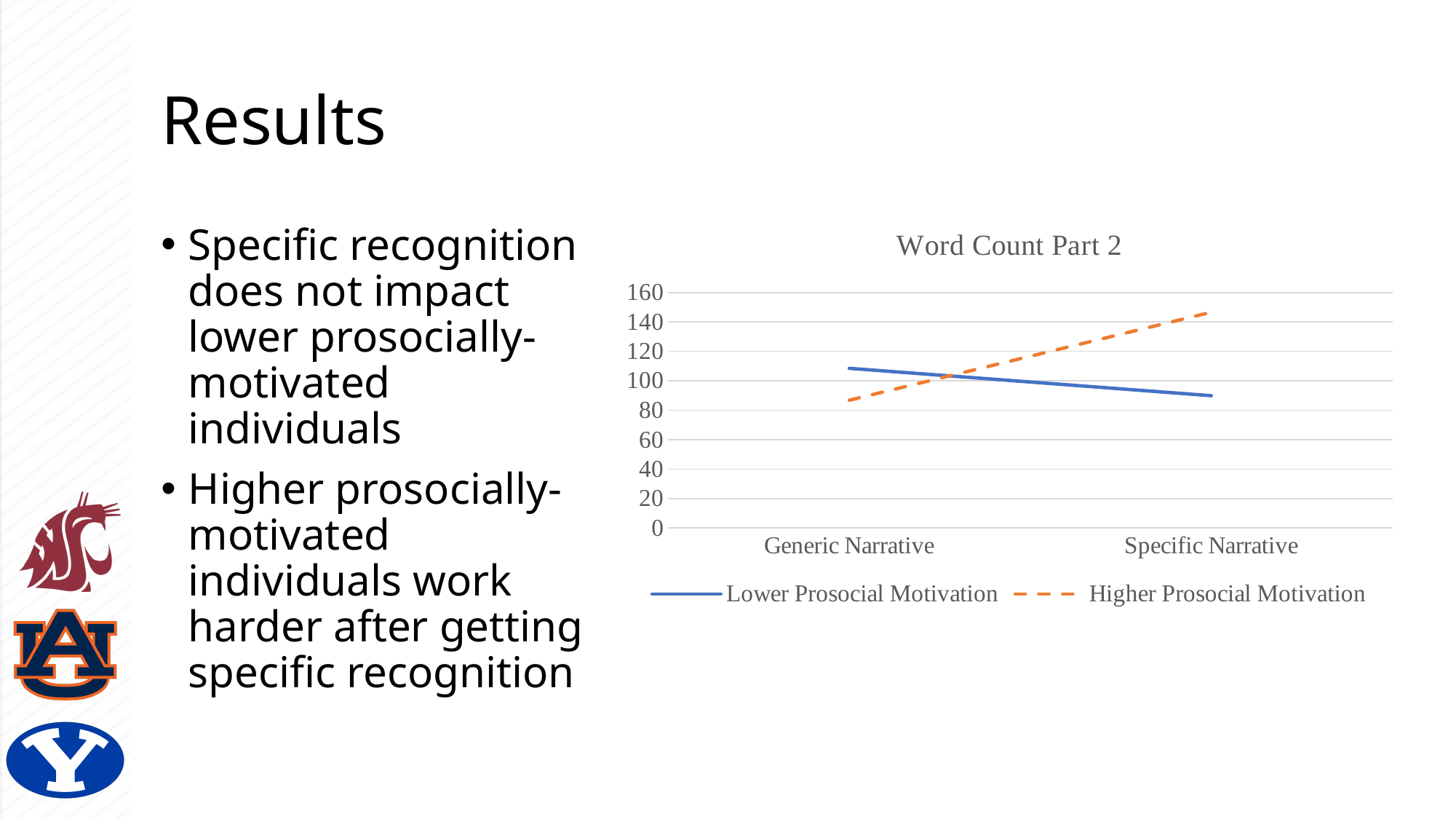
Does the Higher Prosocial Motivation line rise or fall from Generic Narrative to Specific Narrative? rise What is the title of the chart? Word Count Part 2 Is the value for Higher Prosocial Motivation at Generic Narrative greater or less than 100? less How many series does the chart legend list? 2 At Specific Narrative, which series has the higher value, Lower Prosocial Motivation or Higher Prosocial Motivation? Higher Prosocial Motivation At Generic Narrative, which series has the higher value, Lower Prosocial Motivation or Higher Prosocial Motivation? Lower Prosocial Motivation Is the value for Higher Prosocial Motivation at Specific Narrative greater or less than 120? greater How many categories are shown on the x axis of the chart? 2 Is the value for Lower Prosocial Motivation at Generic Narrative greater or less than 100? greater Which series is drawn with a dashed line? Higher Prosocial Motivation What type of chart is shown on the slide? line chart Does the Lower Prosocial Motivation line rise or fall from Generic Narrative to Specific Narrative? fall